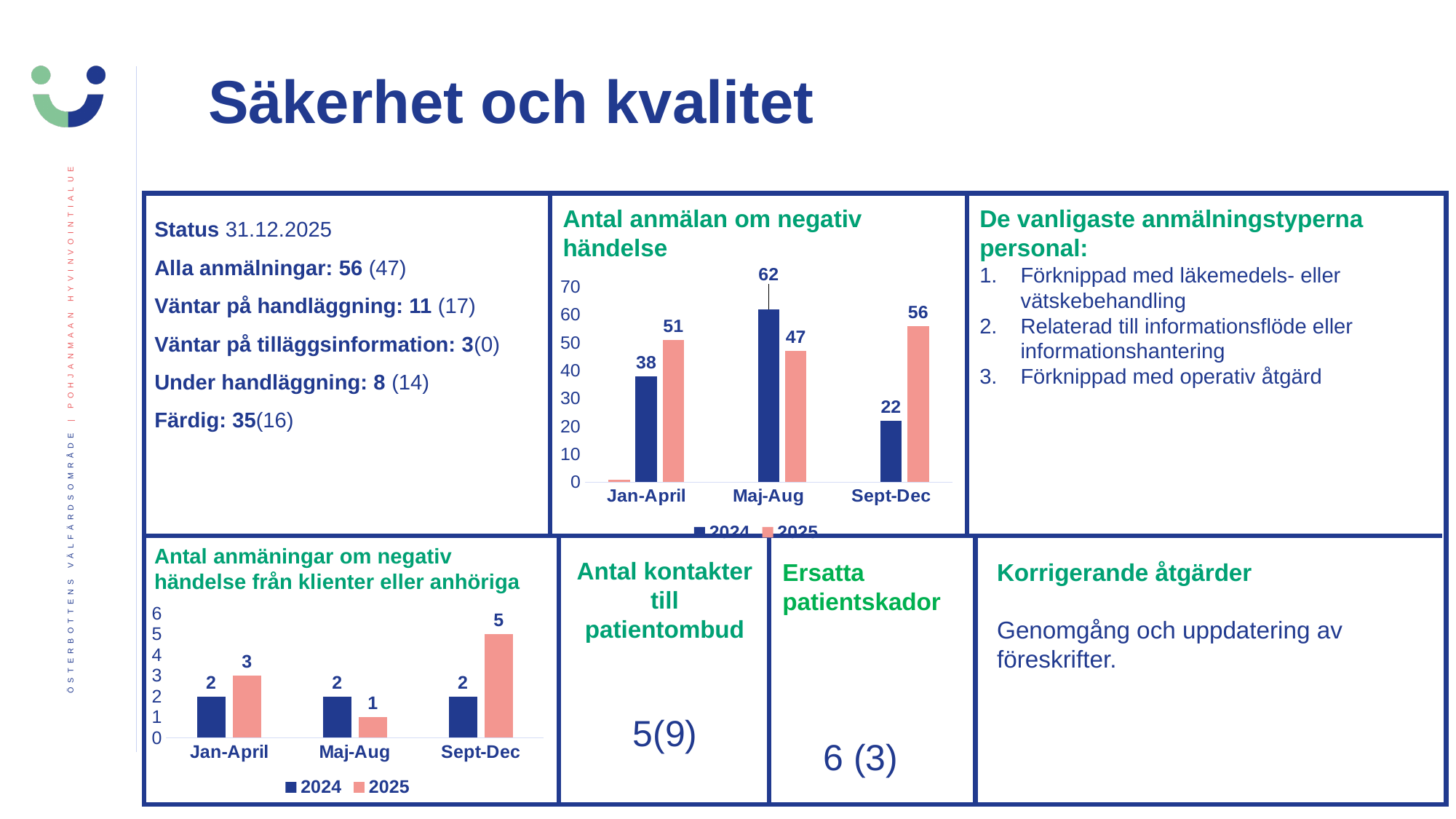
In the chart 'Antal anmälan om negativ händelse', which is larger in Jan-April, the 2024 value or the 2025 value? 2025 In the chart 'Antal anmälan om negativ händelse', how many series does the legend list? 2 In the chart 'Antal anmäningar om negativ händelse från klienter eller anhöriga', which period has the highest value for 2025? Sept-Dec In the chart 'Antal anmälan om negativ händelse', what is the value for 2025 in Sept-Dec? 56 In the chart 'Antal anmäningar om negativ händelse från klienter eller anhöriga', what is the value for 2025 in Maj-Aug? 1 In the chart 'Antal anmälan om negativ händelse', what is the difference between the 2025 and 2024 values in Sept-Dec? 34 In the chart 'Antal anmäningar om negativ händelse från klienter eller anhöriga', what is the value for 2025 in Sept-Dec? 5 What kind of chart is 'Antal anmäningar om negativ händelse från klienter eller anhöriga'? Bar chart In the chart 'Antal anmälan om negativ händelse', which period has the highest value for 2024? Maj-Aug In the chart 'Antal anmäningar om negativ händelse från klienter eller anhöriga', how many periods are shown on the x axis? 3 In the chart 'Antal anmälan om negativ händelse', which period has the lowest value for 2025? Maj-Aug In the chart 'Antal anmälan om negativ händelse', what is the value for 2024 in Maj-Aug? 62